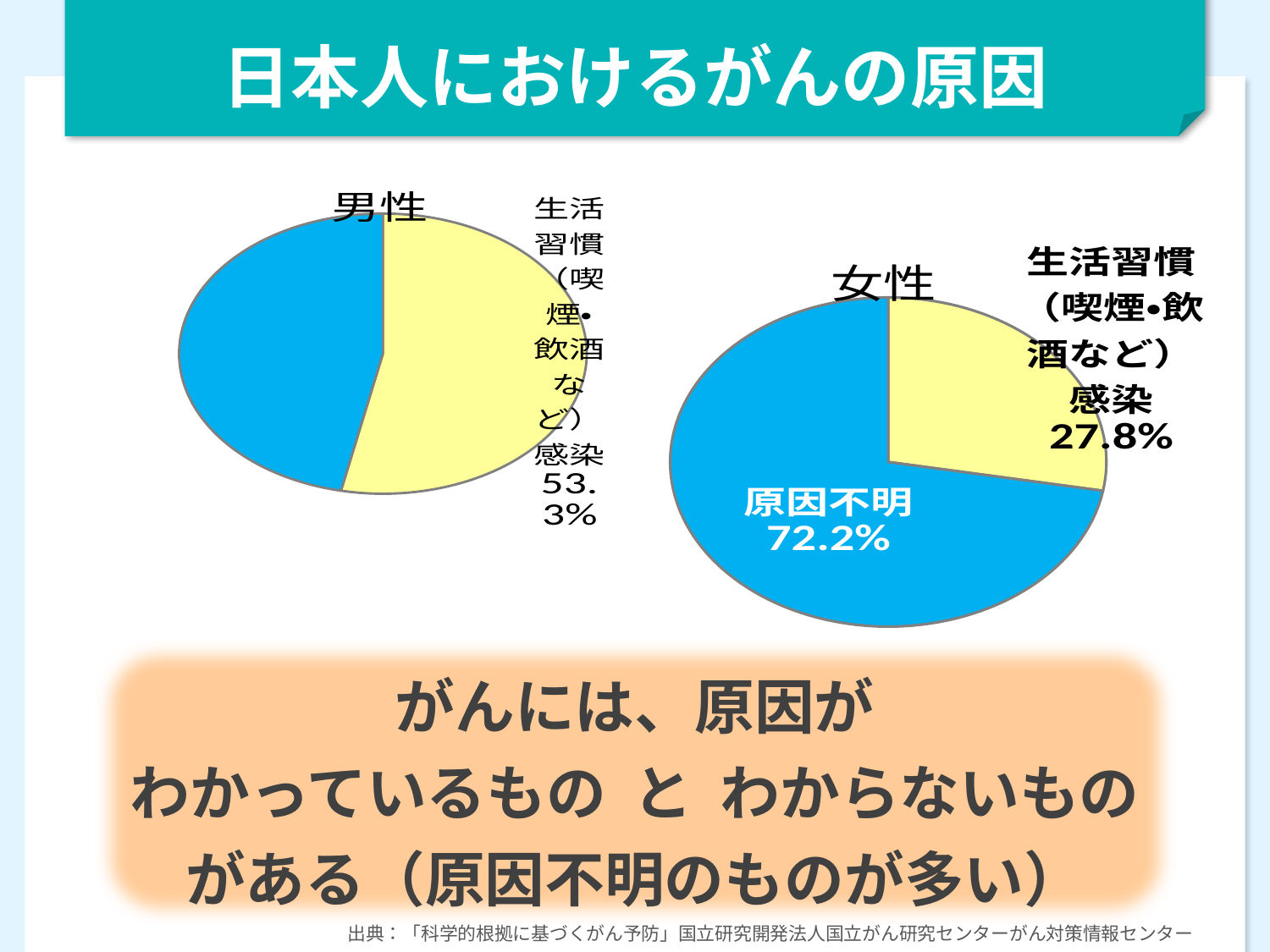
In the 女性 chart, what colour is the 原因不明 slice? blue In the 女性 chart, what percentage is shown for 生活習慣（喫煙・飲酒など）感染? 27.8% What kind of chart is used for the 男性 chart? pie chart In the 女性 chart, which slice is the largest? 原因不明 In the 女性 chart, what percentage is shown for 原因不明? 72.2% In the 女性 chart, which slice is the smallest? 生活習慣（喫煙・飲酒など）感染 How many slices does the 女性 pie chart have? 2 In the 男性 chart, what percentage is shown for 生活習慣（喫煙・飲酒など）感染? 53.3% In the 男性 chart, what colour is the 生活習慣（喫煙・飲酒など）感染 slice? yellow Which is larger: the 生活習慣（喫煙・飲酒など）感染 share in the 男性 chart or in the 女性 chart? 男性 In the 女性 chart, what is the difference between the 原因不明 slice and the 生活習慣（喫煙・飲酒など）感染 slice? 44.4% How many pie charts are shown on the slide? 2